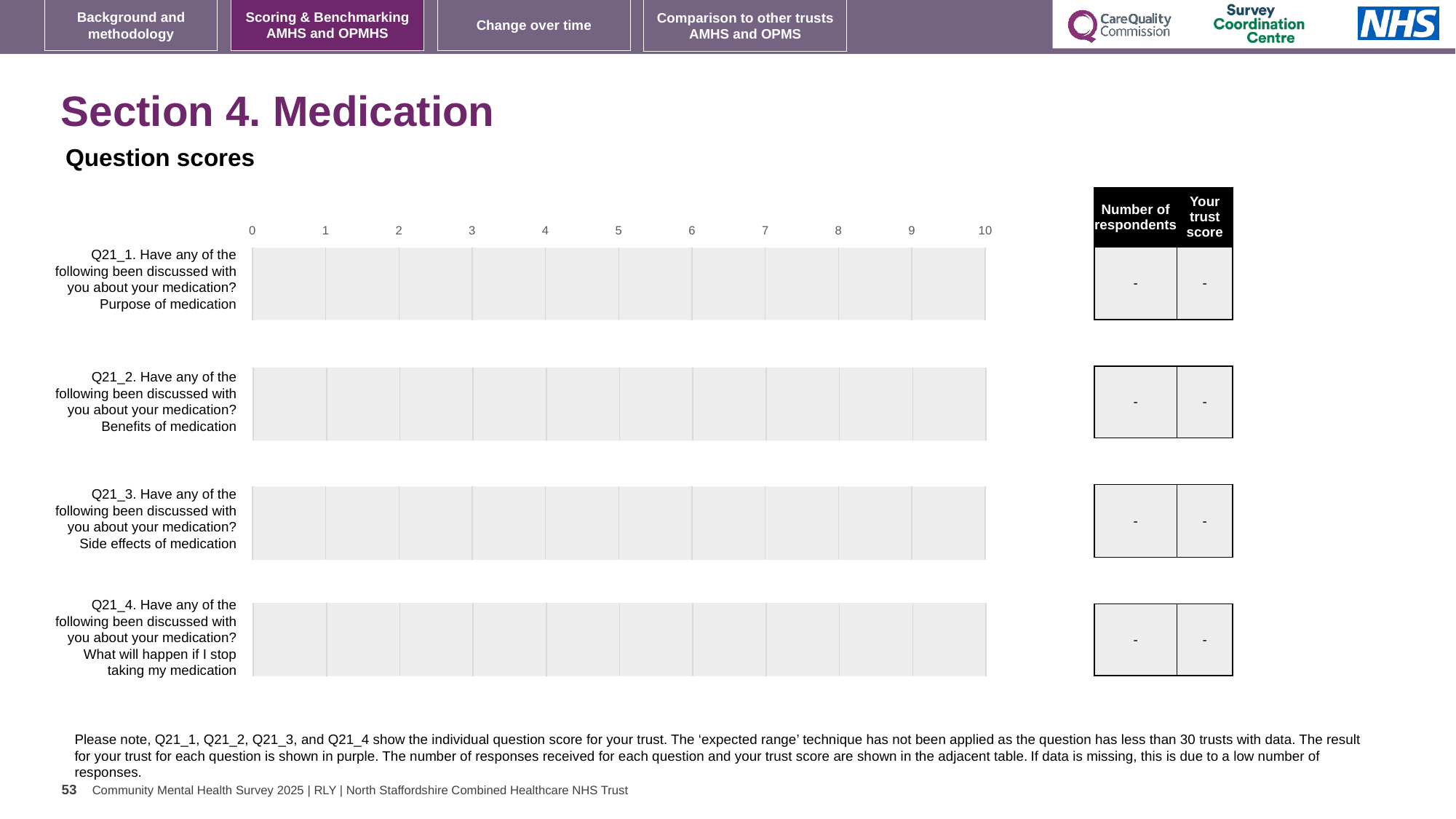
What is the number of respondents shown in the table for Q21_2 (Benefits of medication)? - What kind of chart is shown on the slide? bar chart How many question categories are listed on the chart? 4 What is the trust score shown in the table for Q21_4 (What will happen if I stop taking my medication)? - What is the number of respondents shown in the table for Q21_1 (Purpose of medication)? - What is the trust score shown in the table for Q21_3 (Side effects of medication)? - What is the highest value shown on the chart's axis? 10 What is the lowest value shown on the chart's axis? 0